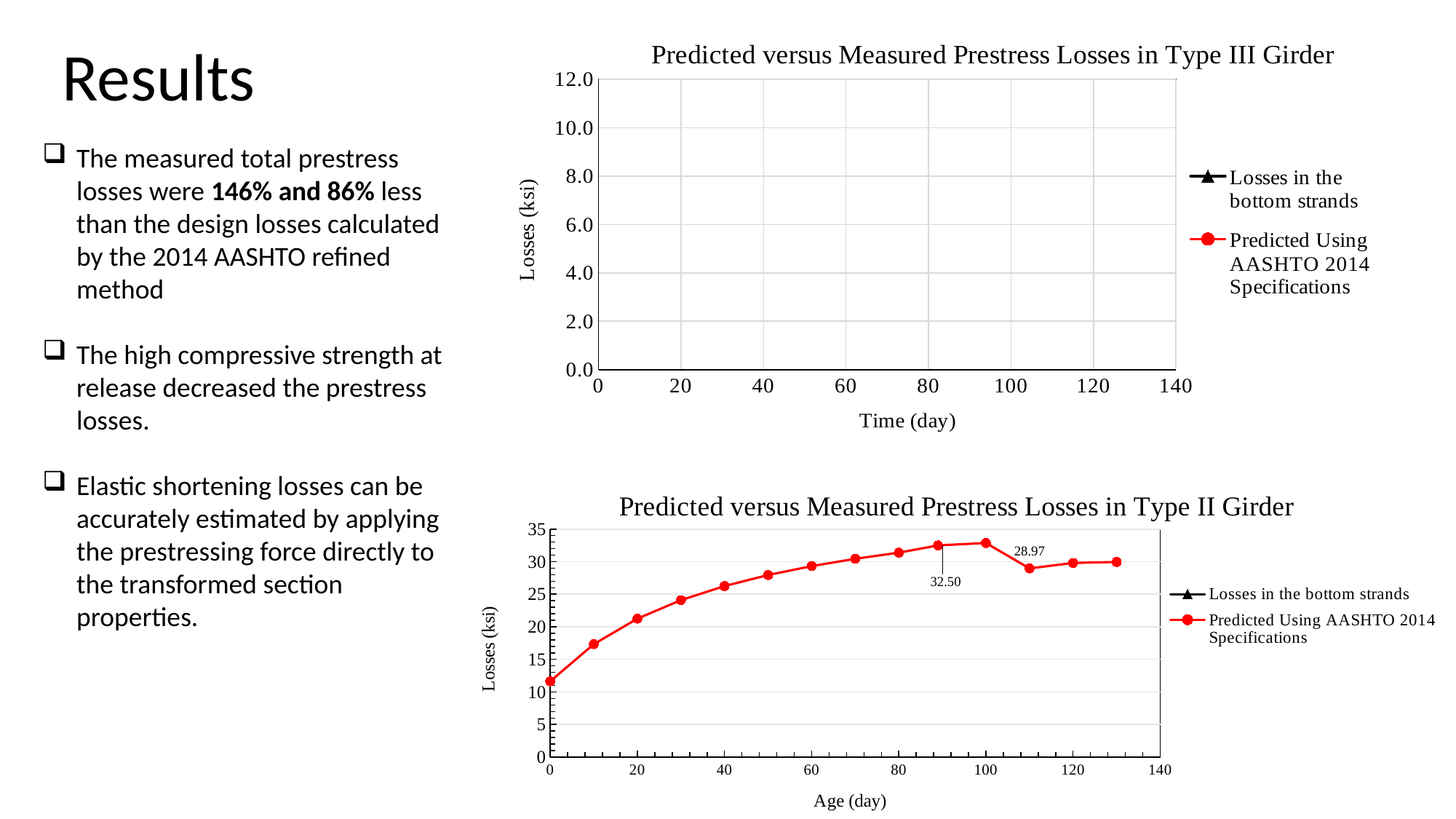
In the bottom chart (Type II Girder), what is the labelled value of the Predicted Using AASHTO 2014 Specifications series at about 110 days? 28.97 What kind of chart is the bottom chart (Type II Girder)? line chart What is the title of the top chart on the slide? Predicted versus Measured Prestress Losses in Type III Girder In the bottom chart (Type II Girder), which labelled value is larger: the one at about 90 days or the one at about 110 days? The one at about 90 days (32.50) In the bottom chart (Type II Girder), do the predicted losses rise or fall between 0 and 100 days? rise In the bottom chart (Type II Girder), is the predicted loss at age 0 days greater or less than 15 ksi? less In the bottom chart (Type II Girder), what is the difference between the two labelled values, 32.50 and 28.97? 3.53 In the bottom chart (Type II Girder), is the predicted loss at age 130 days greater or less than 25 ksi? greater In the bottom chart (Type II Girder), how many data points are plotted on the Predicted Using AASHTO 2014 Specifications line? 14 What is the x-axis label of the bottom chart (Type II Girder)? Age (day) In the bottom chart (Type II Girder), what is the labelled value of the Predicted Using AASHTO 2014 Specifications series at about 90 days? 32.50 How many series does the legend of the bottom chart (Type II Girder) list? 2